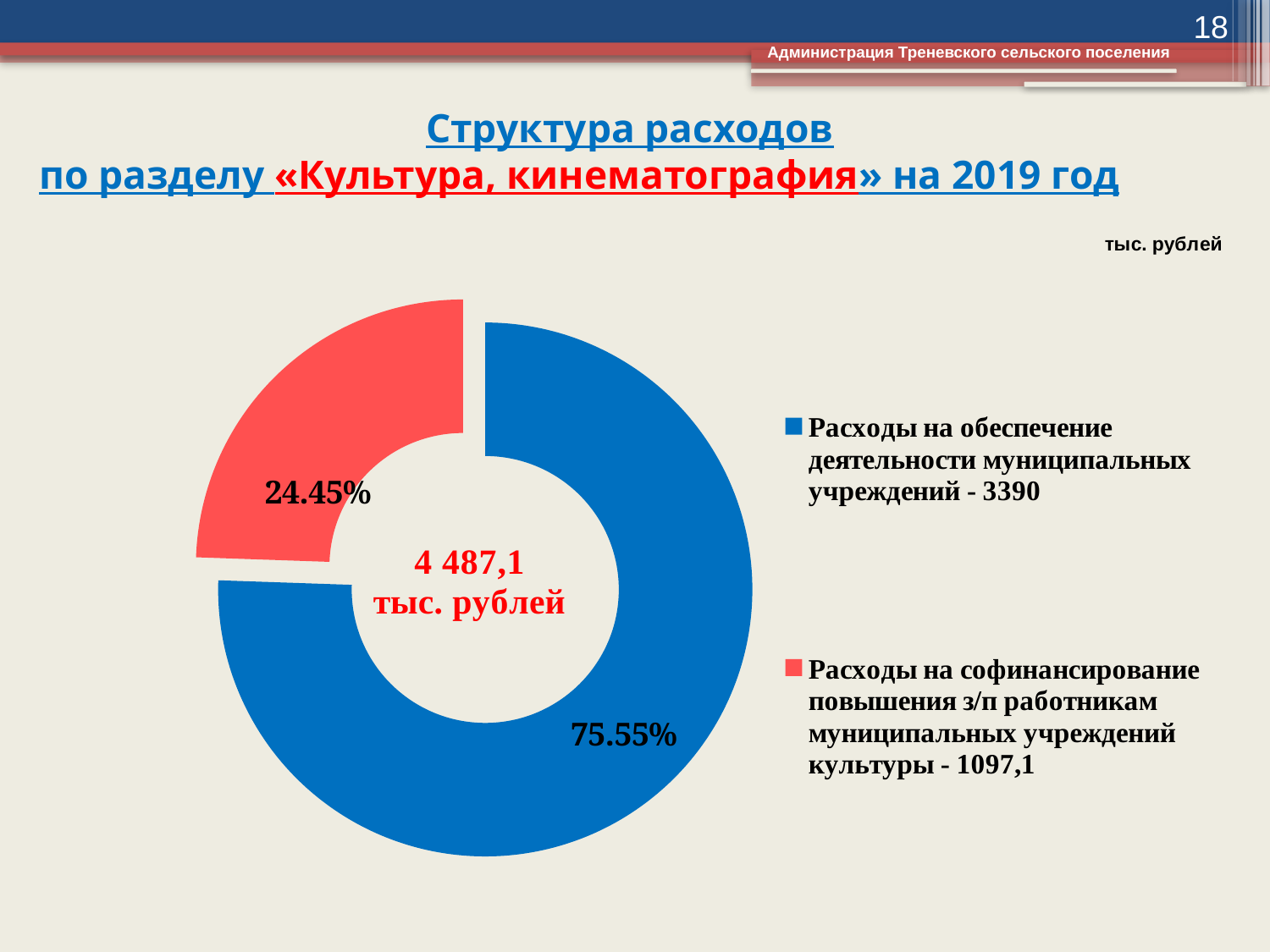
What is the difference in percentage points between the two slices of the chart? 51.1 percentage points Which category has the largest slice of the chart? Расходы на обеспечение деятельности муниципальных учреждений What type of chart is shown on the slide? Doughnut (pie) chart How many slices does the chart have? 2 How many entries does the legend list? 2 What total amount is shown in the centre of the chart? 4 487,1 тыс. рублей What value is given in the legend for «Расходы на софинансирование повышения з/п работникам муниципальных учреждений культуры»? 1097,1 Which category has the smallest slice of the chart? Расходы на софинансирование повышения з/п работникам муниципальных учреждений культуры What colour is the slice for «Расходы на софинансирование повышения з/п работникам муниципальных учреждений культуры»? Red What share of the chart does the slice for «Расходы на обеспечение деятельности муниципальных учреждений» take? 75.55% What share of the chart does the slice for «Расходы на софинансирование повышения з/п работникам муниципальных учреждений культуры» take? 24.45% What value is given in the legend for «Расходы на обеспечение деятельности муниципальных учреждений»? 3390